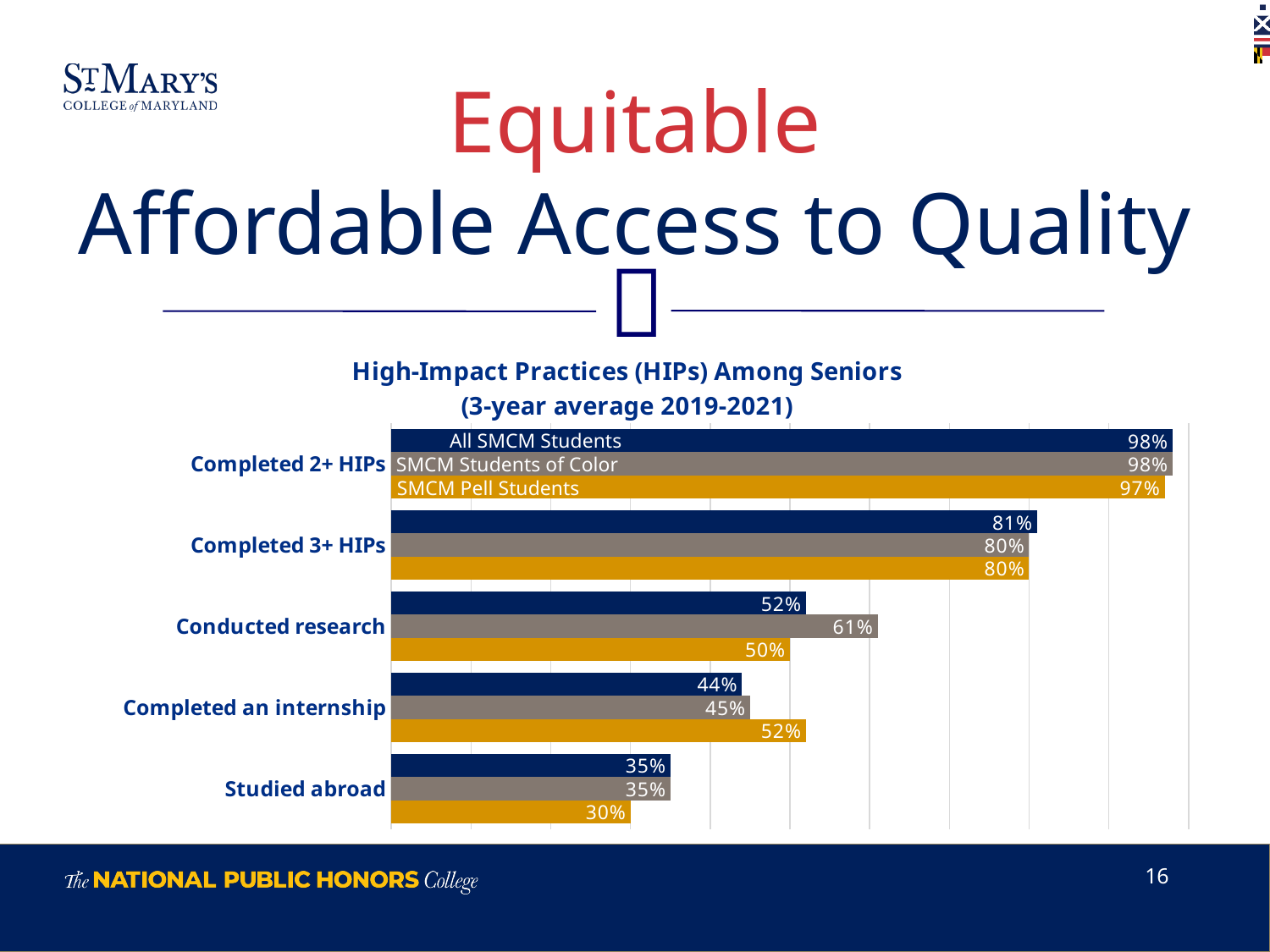
What is the value for SMCM Pell Students who completed 2+ HIPs? 97% What is the value for All SMCM Students who completed an internship? 44% What kind of chart is shown on the slide? Bar chart Which category has the highest value for SMCM Students of Color? Completed 2+ HIPs What percentage of SMCM Pell Students studied abroad? 30% What percentage of SMCM Students of Color conducted research? 61% How many categories are shown on the chart? 5 Which category has the lowest value for All SMCM Students? Studied abroad For Completed an internship, which group has the larger value: SMCM Pell Students or SMCM Students of Color? SMCM Pell Students What is the difference between SMCM Students of Color and All SMCM Students for Conducted research? 9% What is the difference between SMCM Pell Students and All SMCM Students for Completed an internship? 8% How many student groups (series) are plotted on the chart? 3